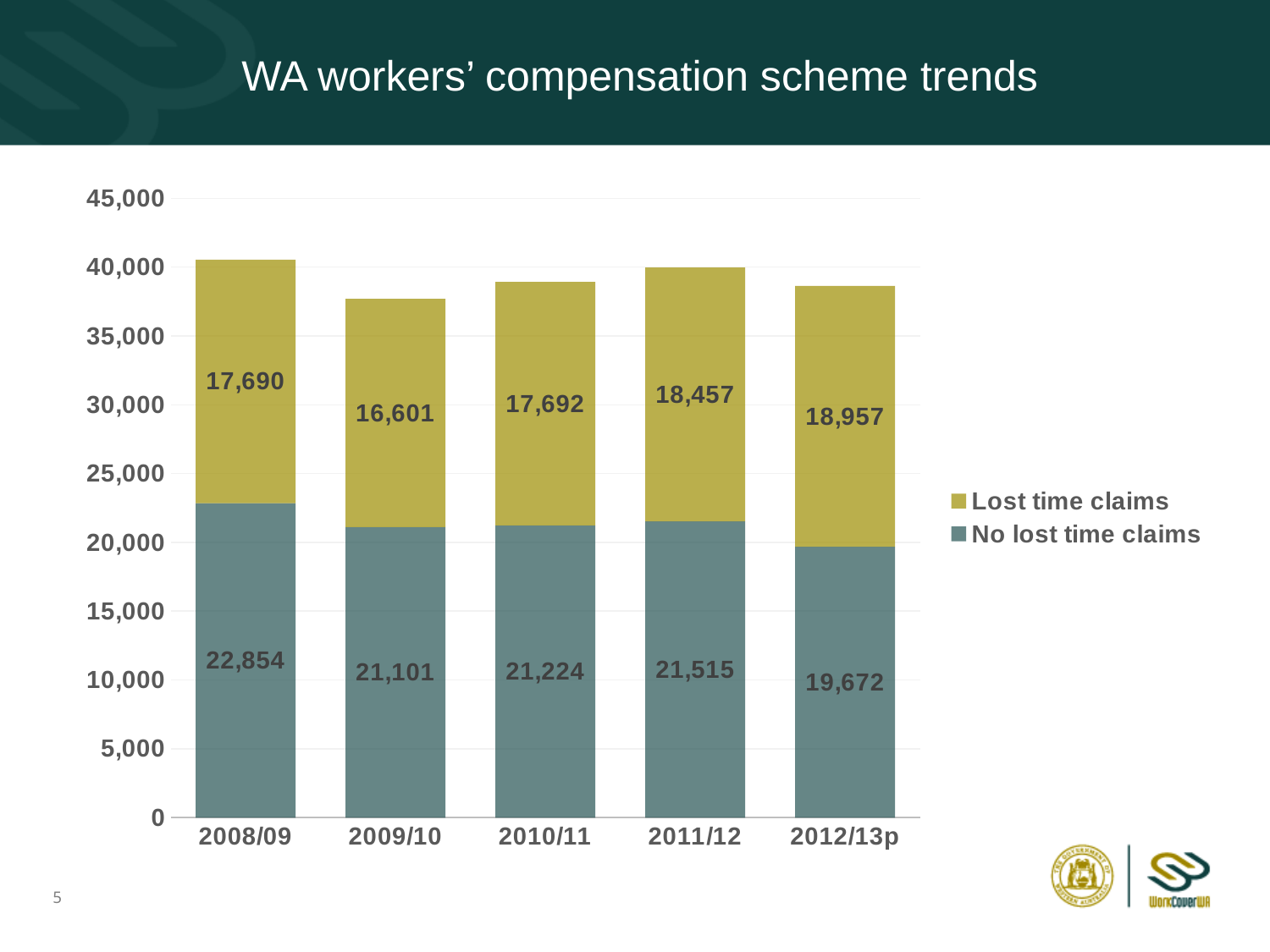
Which year has the highest number of Lost time claims? 2012/13p Which series is shown in gold? Lost time claims Do Lost time claims rise or fall from 2009/10 to 2012/13p? Rise What is the value of No lost time claims for 2009/10? 21,101 What is the difference between No lost time claims in 2008/09 and 2012/13p? 3,182 What type of chart is shown on the slide? Stacked bar chart How many series does the legend list? 2 Which year has the lowest number of No lost time claims? 2012/13p What is the total of the stacked bar for 2008/09? 40,544 What is the value of Lost time claims for 2011/12? 18,457 Which is larger in 2010/11: Lost time claims or No lost time claims? No lost time claims How many years are shown on the x axis? 5